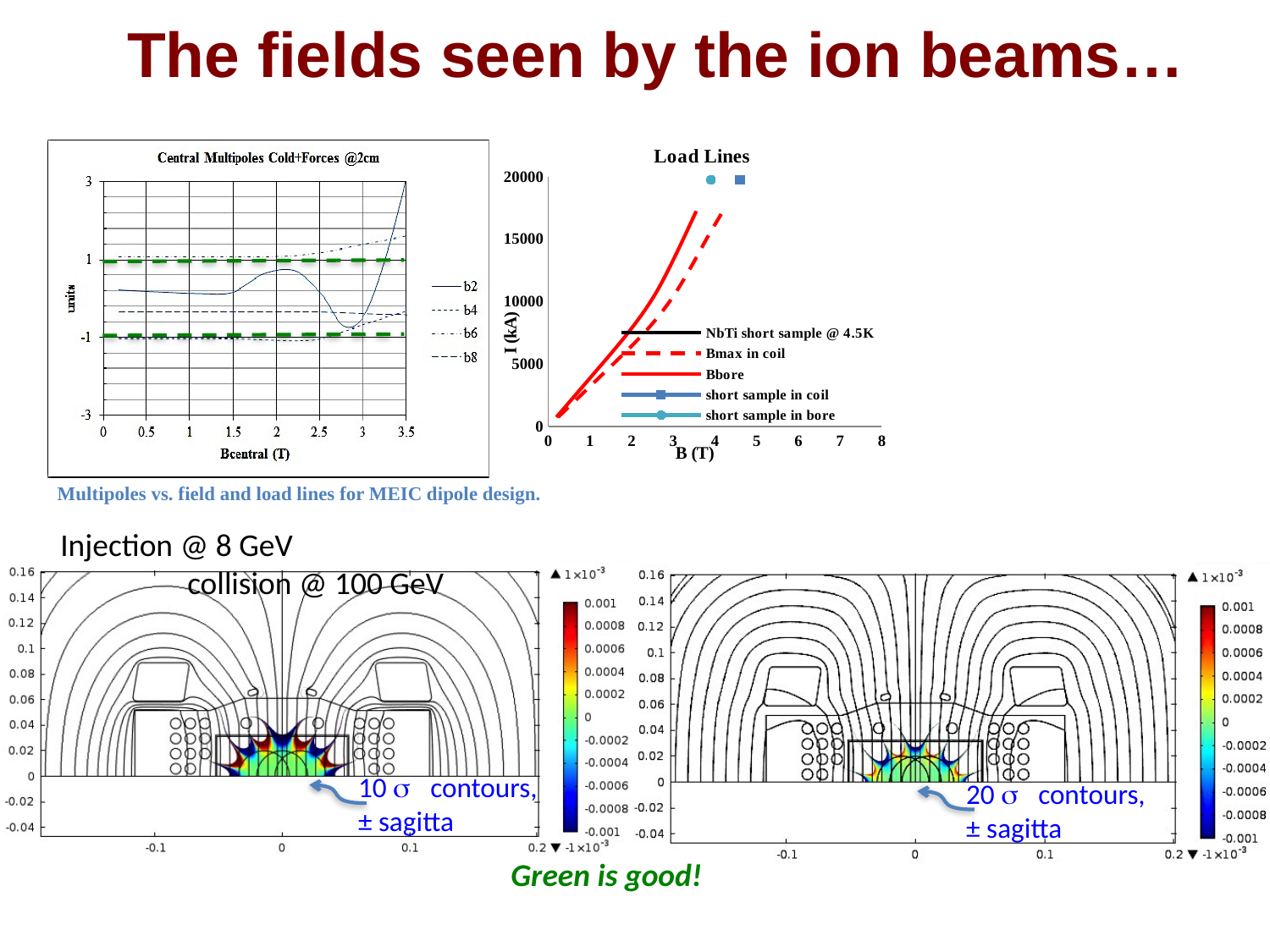
In the 'Load Lines' chart, what is the label of the y axis? I (kA) In the 'Central Multipoles Cold+Forces @2cm' chart, is the value of b2 at Bcentral = 0.5 T greater or less than 1? less How many entries does the legend of the 'Load Lines' chart list? 5 In the 'Central Multipoles Cold+Forces @2cm' chart, is the value of b2 at Bcentral = 3.5 T greater or less than 1? greater In the 'Central Multipoles Cold+Forces @2cm' chart, what is the label of the x axis? Bcentral (T) In the 'Central Multipoles Cold+Forces @2cm' chart, does the b2 series rise or fall between Bcentral = 3 T and 3.5 T? rise How many series does the legend of the 'Central Multipoles Cold+Forces @2cm' chart list? 4 What kind of chart is the 'Load Lines' chart? line chart What kind of chart is the 'Central Multipoles Cold+Forces @2cm' chart? line chart In the 'Load Lines' chart, at B = 3 T, which is higher: 'Bbore' or 'Bmax in coil'? Bbore In the 'Load Lines' chart, is the value of 'Bbore' at B = 3 T greater or less than 10000? greater